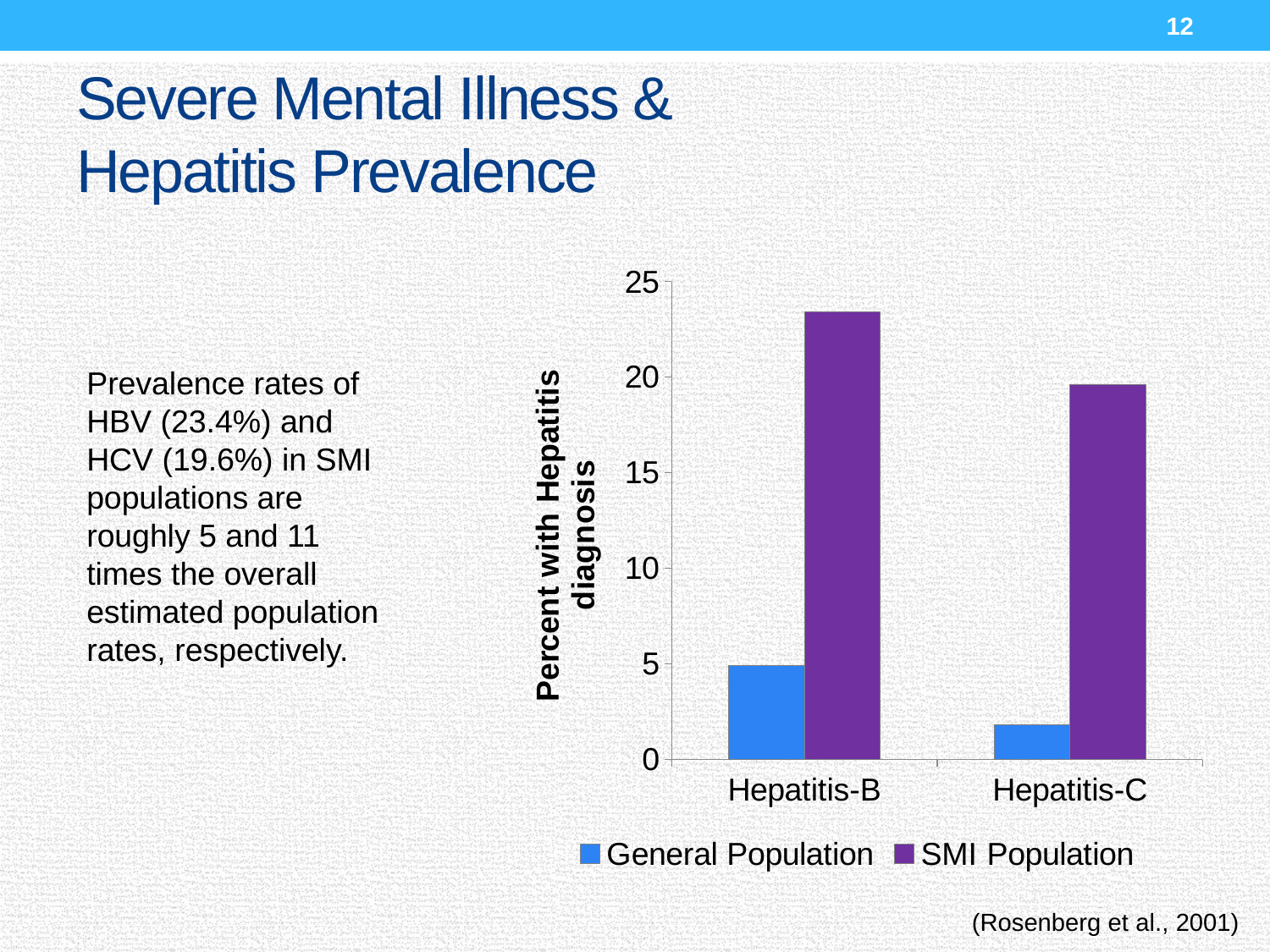
Which category has the higher SMI Population value, Hepatitis-B or Hepatitis-C? Hepatitis-B Is the General Population value for Hepatitis-B greater or less than 10? less What is the prevalence rate of Hepatitis-B (HBV) in the SMI Population? 23.4% How many categories are shown on the x axis? 2 Is the SMI Population value for Hepatitis-B greater or less than 20? greater What is the prevalence rate of Hepatitis-C (HCV) in the SMI Population? 19.6% Is the General Population value for Hepatitis-C greater or less than 5? less What is the difference between the SMI Population prevalence rates for Hepatitis-B and Hepatitis-C? 3.8% What kind of chart is shown on the slide? bar chart What is the label of the y axis? Percent with Hepatitis diagnosis For Hepatitis-C, which series has the larger value, General Population or SMI Population? SMI Population How many series does the legend list? 2